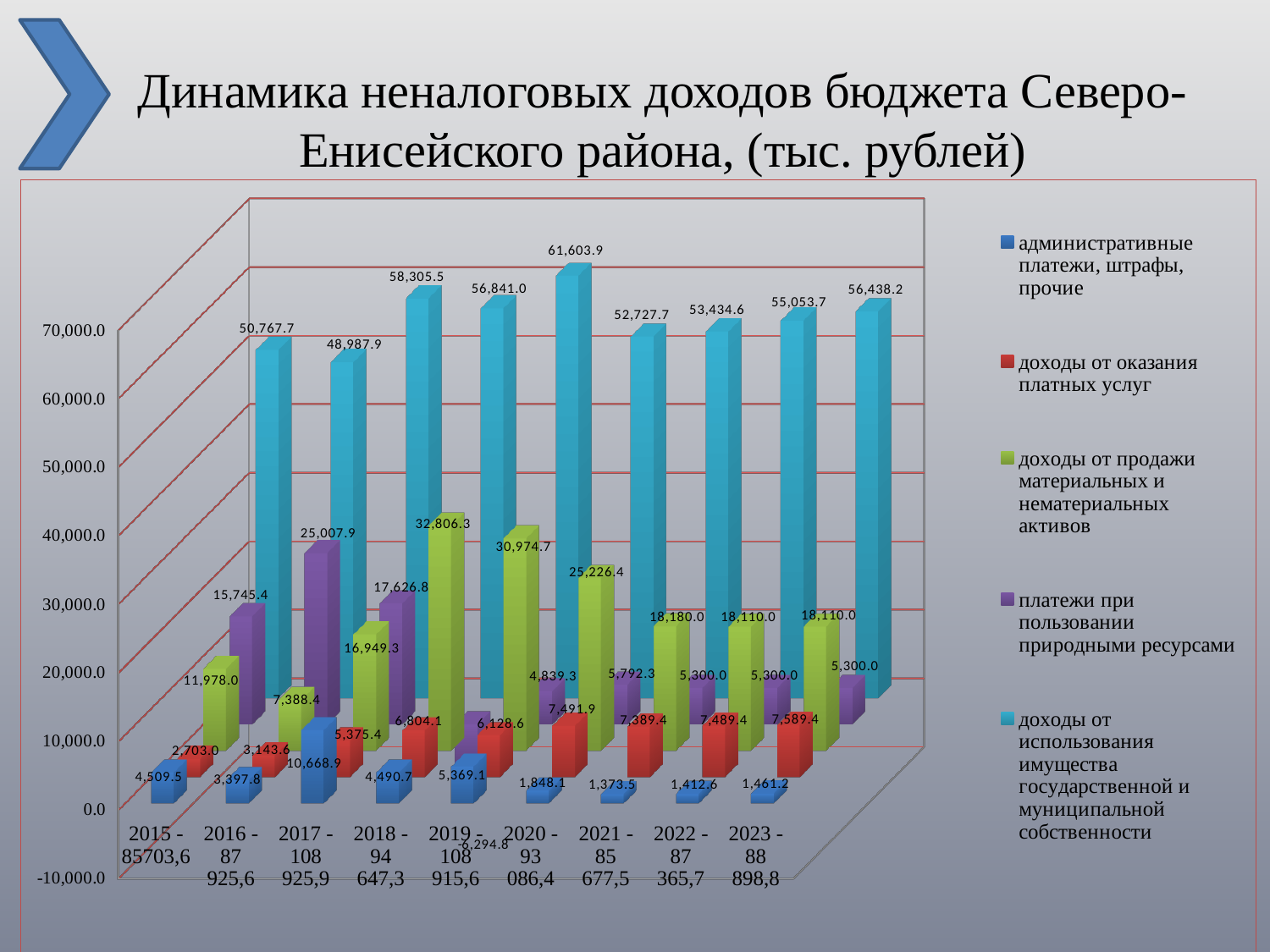
What is the value of доходы от использования имущества государственной и муниципальной собственности for 2015? 50,767.7 What is the highest value shown for доходы от продажи материальных и нематериальных активов? 32,806.3 What is the lowest value shown for доходы от использования имущества государственной и муниципальной собственности? 48,987.9 What is the difference between the 2023 and 2015 values of доходы от использования имущества государственной и муниципальной собственности? 5,670.5 Which is larger in 2015: административные платежи, штрафы, прочие or доходы от оказания платных услуг? административные платежи, штрафы, прочие How many years are shown along the x axis? 9 What is the value of административные платежи, штрафы, прочие for 2023? 1,461.2 What is the value of доходы от использования имущества государственной и муниципальной собственности for 2023? 56,438.2 How many series does the legend list? 5 What is the highest value shown for доходы от использования имущества государственной и муниципальной собственности? 61,603.9 What kind of chart is shown on the slide? bar chart What is the value of административные платежи, штрафы, прочие for 2015? 4,509.5